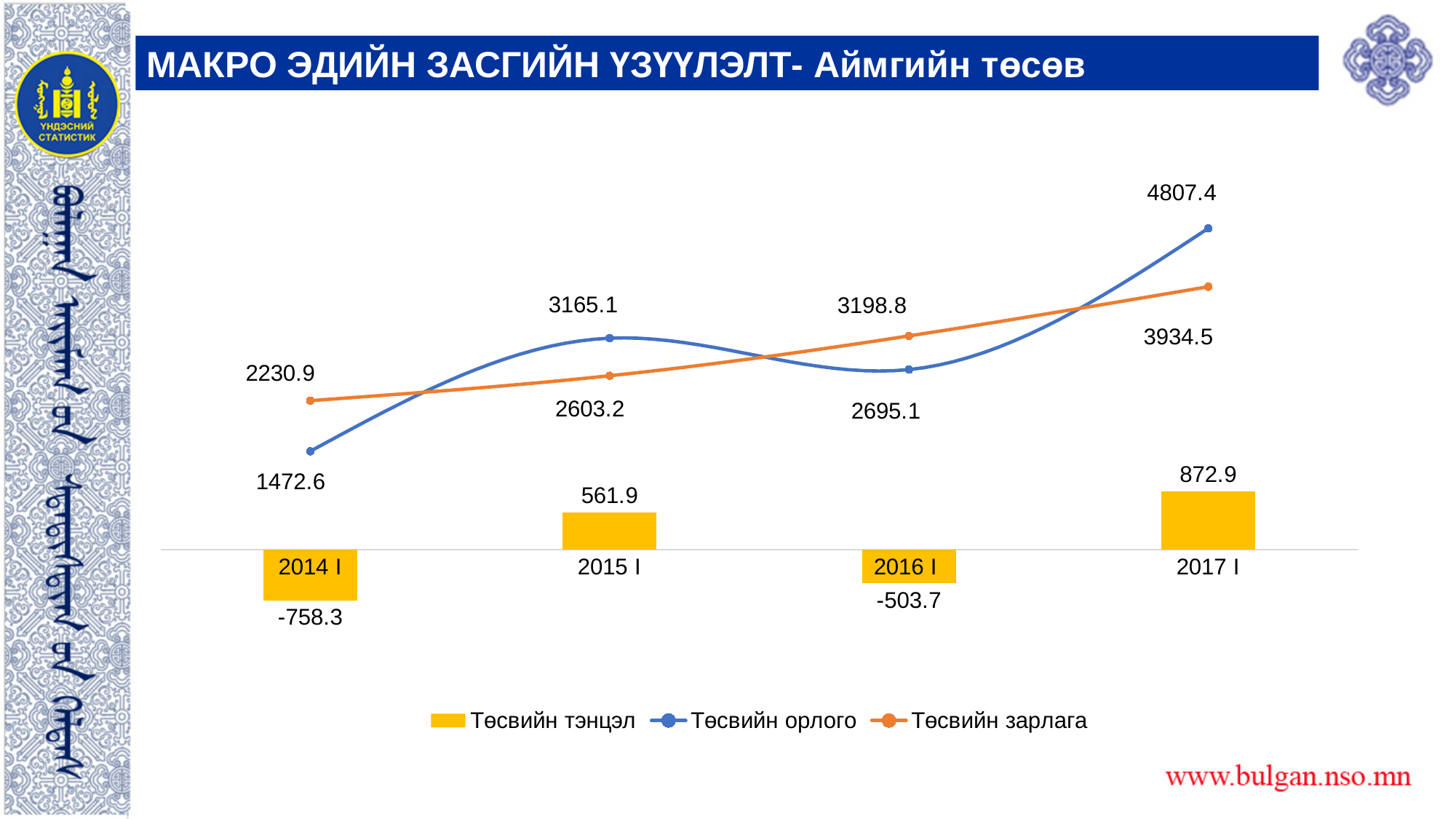
Which is larger in 2016 I, Төсвийн орлого or Төсвийн зарлага? Төсвийн зарлага In which period is Төсвийн тэнцэл the highest? 2017 I How many series does the legend list? 3 What is the value of Төсвийн орлого for 2015 I? 3165.1 What is the difference between Төсвийн орлого and Төсвийн зарлага in 2017 I? 872.9 What is the value of Төсвийн орлого for 2017 I? 4807.4 Which series is shown as bars in the chart? Төсвийн тэнцэл How many periods are shown on the x axis? 4 What is the value of Төсвийн тэнцэл for 2016 I? -503.7 What is the value of Төсвийн зарлага for 2014 I? 2230.9 In which period is Төсвийн орлого the lowest? 2014 I Does Төсвийн зарлага rise or fall from 2014 I to 2017 I? rise